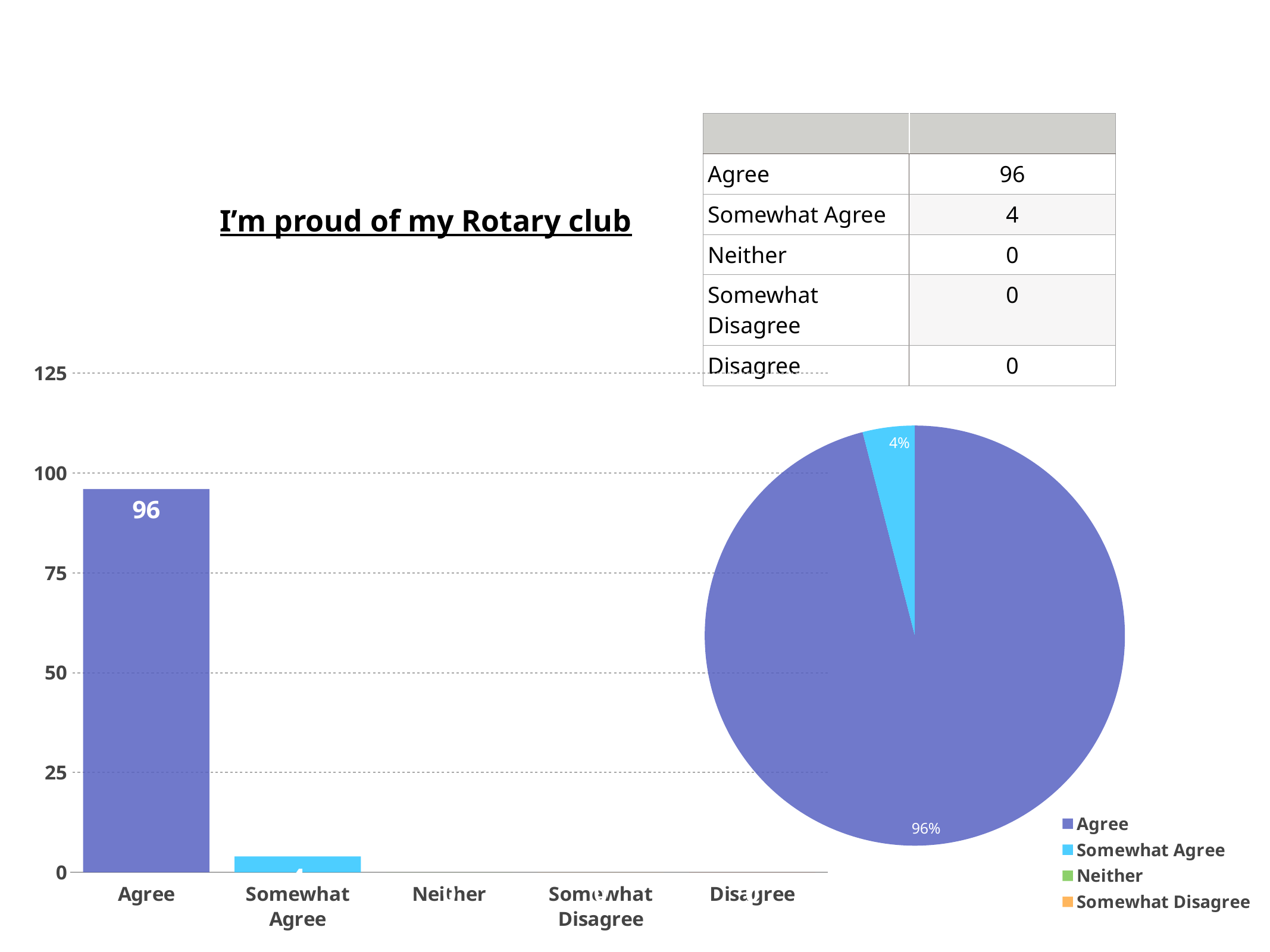
In the bar chart on the left, which category has the highest value? Agree In the pie chart on the right, what share does the Agree slice have? 96% What kind of chart is the chart on the right of the slide? pie chart In the bar chart on the left, is the value for Somewhat Agree greater or less than 25? less What kind of chart is the chart on the left of the slide? bar chart What is the title shown above the bar chart on the left? I'm proud of my Rotary club In the pie chart on the right, what share does the Somewhat Agree slice have? 4% In the bar chart on the left, is the value for Agree greater or less than 75? greater How many entries does the legend of the pie chart on the right list? 4 In the bar chart on the left, what is the value for Agree? 96 In the bar chart on the left, which is larger, the value for Agree or the value for Somewhat Agree? Agree In the bar chart on the left, how many categories are shown on the x axis? 5